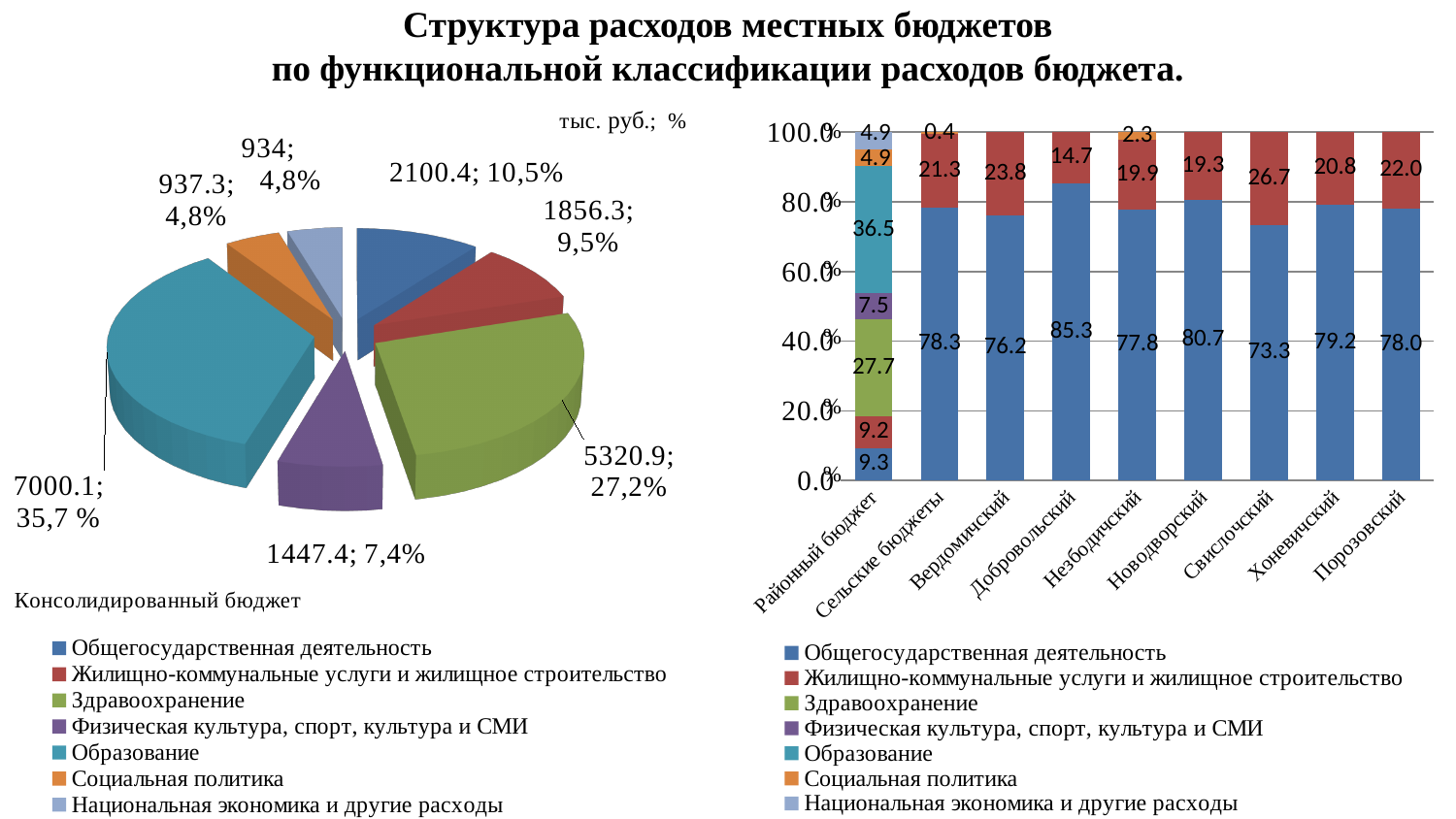
In the pie chart on the left, how many slices are there? 7 In the pie chart on the left, what value and share are shown for Образование? 7000.1; 35,7 % In the stacked bar chart on the right, what is the value of Общегосударственная деятельность for Добровольский? 85.3 In the stacked bar chart on the right, what is the difference between the Жилищно-коммунальные услуги values for Свислочский and Добровольский? 12.0 In the stacked bar chart on the right, what is the value of Образование for Районный бюджет? 36.5 How many series does the legend of the stacked bar chart on the right list? 7 In the pie chart on the left, which is larger: the value for Общегосударственная деятельность or the value for Жилищно-коммунальные услуги и жилищное строительство? Общегосударственная деятельность In the pie chart on the left, which category has the largest slice? Образование In the stacked bar chart on the right, which category has the lowest value for Общегосударственная деятельность? Районный бюджет How many categories are shown on the x axis of the stacked bar chart on the right? 9 In the pie chart on the left, what share is shown for Здравоохранение? 27,2% In the stacked bar chart on the right, which category has the highest value for Общегосударственная деятельность? Добровольский